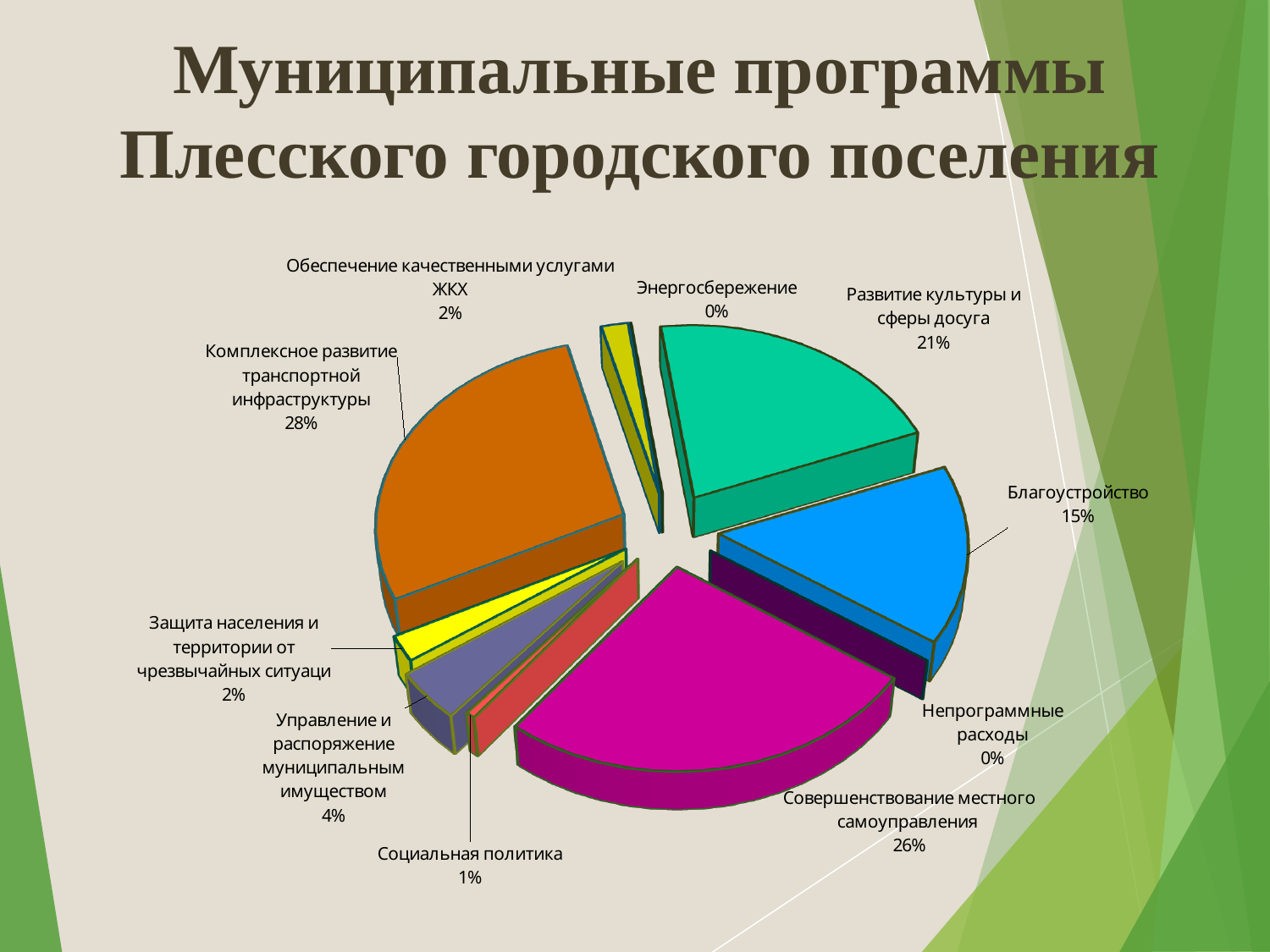
Which is larger: Благоустройство or Развитие культуры и сферы досуга? Развитие культуры и сферы досуга Which category has the largest share of the pie? Комплексное развитие транспортной инфраструктуры What percentage is shown for Благоустройство? 15% What is the difference in percentage points between Комплексное развитие транспортной инфраструктуры and Совершенствование местного самоуправления? 2% How many categories are labelled with 0%? 2 How many categories are shown in the pie chart? 10 What percentage is shown for Развитие культуры и сферы досуга? 21% What percentage is shown for Совершенствование местного самоуправления? 26% What share of the pie does Комплексное развитие транспортной инфраструктуры have? 28% What percentage is shown for Управление и распоряжение муниципальным имуществом? 4% What kind of chart is shown on the slide? Pie chart What percentage is shown for Социальная политика? 1%